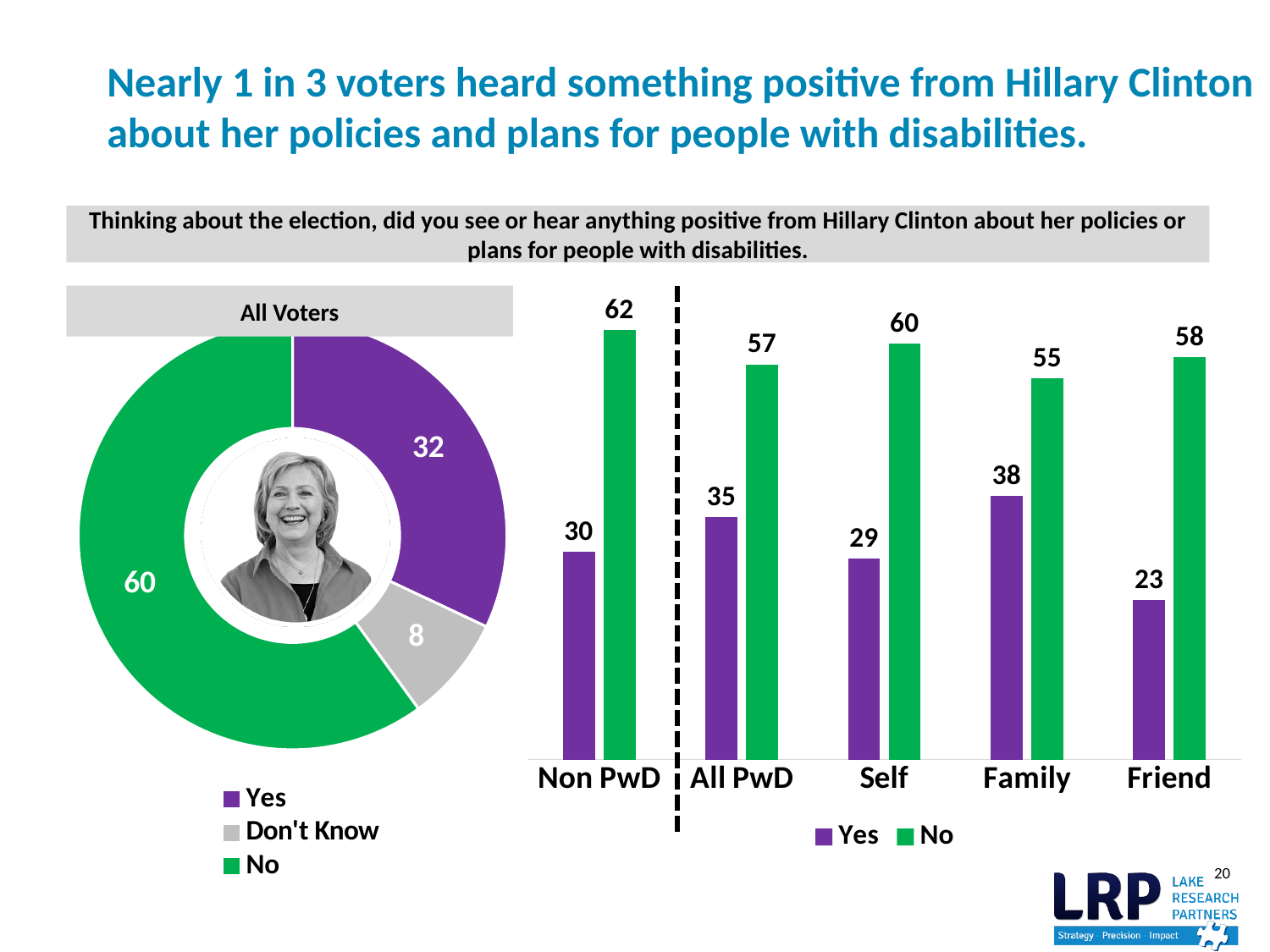
In the All Voters chart on the left, which category has the largest share? No In the All Voters chart on the left, what is the value for Yes? 32 In the bar chart on the right, what is the Yes value for Family? 38 In the bar chart on the right, is the Yes value for All PwD larger or smaller than the Yes value for Self? Larger In the All Voters chart on the left, how many categories does the legend list? 3 In the All Voters chart on the left, what is the value for Don't Know? 8 In the bar chart on the right, what is the No value for Non PwD? 62 In the bar chart on the right, which category has the highest No value? Non PwD In the bar chart on the right, how many series does the legend list? 2 In the bar chart on the right, what is the difference between the No and Yes values for Self? 31 In the bar chart on the right, which category has the lowest Yes value? Friend What kind of chart is the All Voters chart on the left? Pie chart (doughnut)